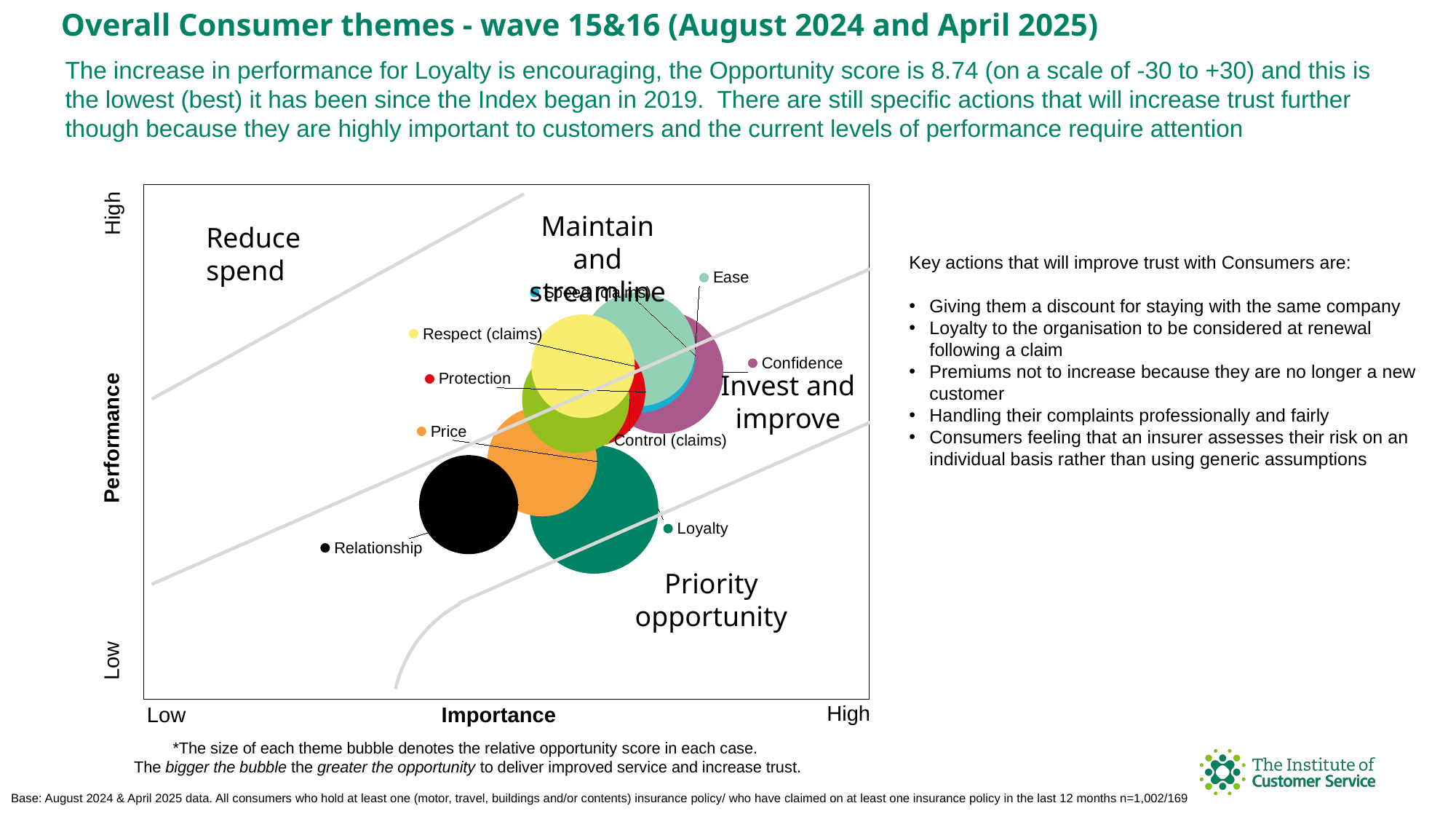
Which theme has the largest bubble on the chart? Loyalty What kind of chart is shown on the slide? Bubble chart Which has higher performance on the chart, Price or Loyalty? Price Which theme bubble has the highest importance on the chart? Confidence What is the label of the vertical axis of the chart? Performance What is the label of the horizontal axis of the chart? Importance How many theme bubbles are plotted on the chart? 9 Which theme bubble has the lowest importance on the chart? Relationship Which theme bubble has the lowest performance on the chart? Loyalty Which has higher importance on the chart, Loyalty or Relationship? Loyalty In which quadrant of the chart does the Loyalty bubble sit? Priority opportunity Which has higher performance on the chart, Respect (claims) or Price? Respect (claims)